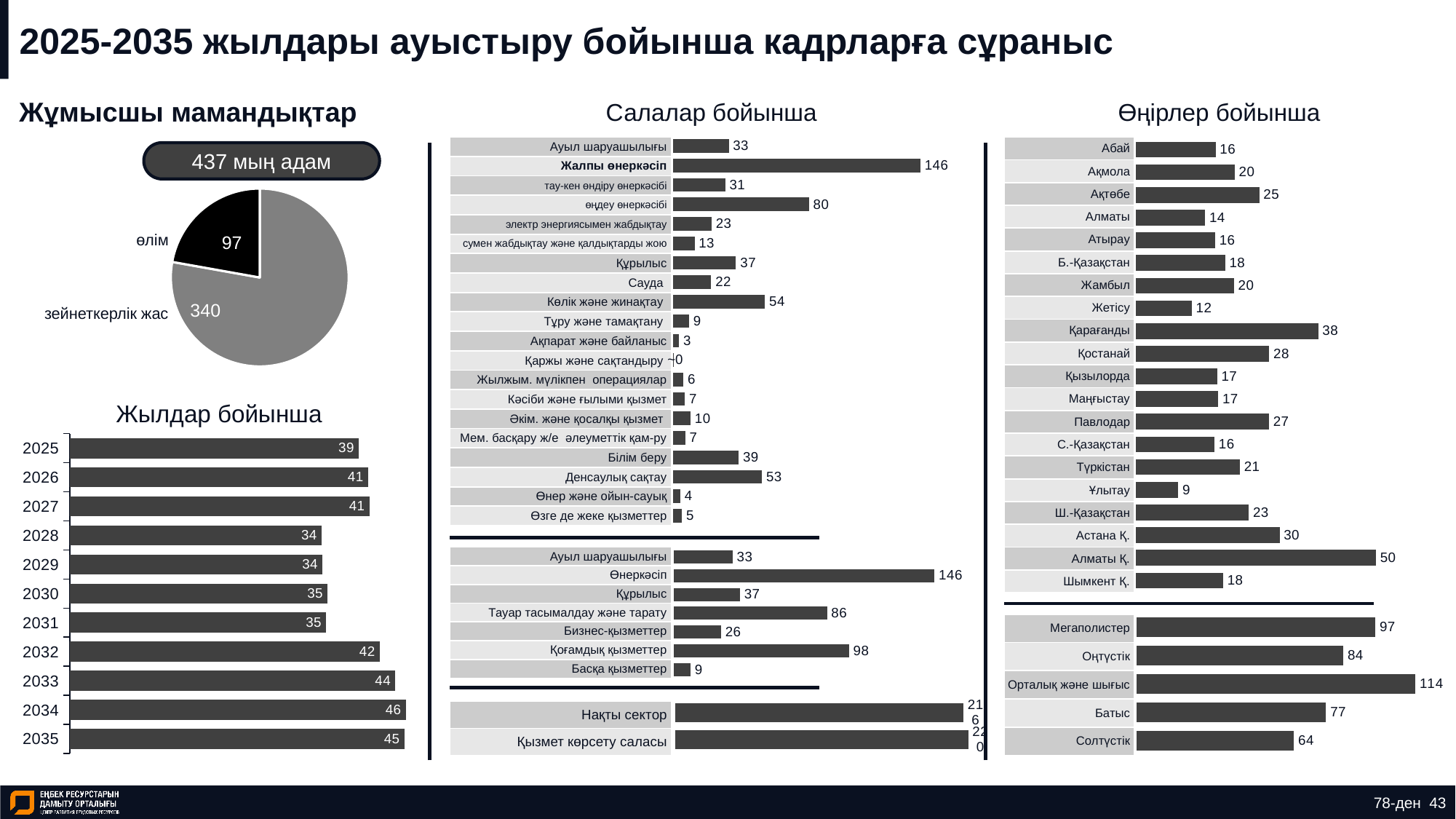
In the "Өңірлер бойынша" chart, which region has the highest value? Алматы Қ. In the "Өңірлер бойынша" chart, which region has the lowest value? Ұлытау In the "Жылдар бойынша" bar chart, how many years are plotted? 11 In the "Жылдар бойынша" bar chart, which year has the lowest value? 2028 and 2029 (34) In the pie chart under "Жұмысшы мамандықтар", what is the value for "зейнеткерлік жас"? 340 In the "Өңірлер бойынша" chart, which is larger: Қарағанды or Қостанай? Қарағанды In the pie chart under "Жұмысшы мамандықтар", what is the value for "өлім"? 97 In the "Жылдар бойынша" bar chart, what is the value for 2034? 46 In the bottom section of the "Өңірлер бойынша" chart, what is the value for "Орталық және шығыс"? 114 In the "Салалар бойынша" chart (top section), which category has the highest value? Жалпы өнеркәсіп In the "Салалар бойынша" chart (top section), what is the value for "Өңдеу өнеркәсібі"? 80 In the "Салалар бойынша" chart (middle section), what is the difference between "Қоғамдық қызметтер" and "Тауар тасымалдау және тарату"? 12